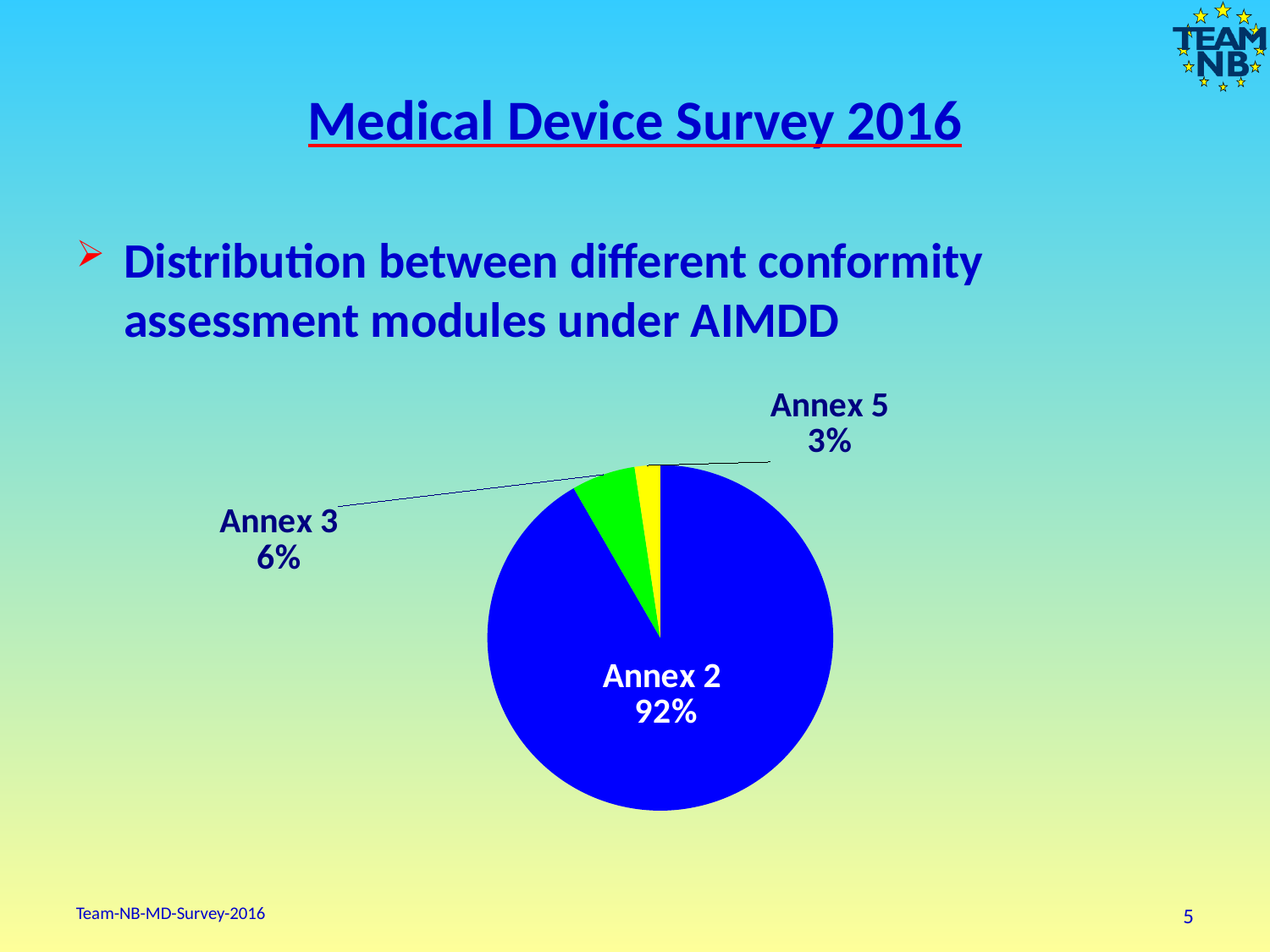
What colour is the Annex 2 slice of the pie? blue What share of the pie does Annex 5 represent? 3% What share of the pie does Annex 3 represent? 6% Which annex has the smallest slice of the pie? Annex 5 Which is larger, the share for Annex 3 or the share for Annex 5? Annex 3 What colour is the Annex 3 slice of the pie? green What is the difference in percentage points between Annex 2 and Annex 3? 86 How many slices does the pie chart have? 3 What share of the pie does Annex 2 represent? 92% What is the difference in percentage points between Annex 3 and Annex 5? 3 What kind of chart is shown on the slide? pie chart Which annex has the largest slice of the pie? Annex 2